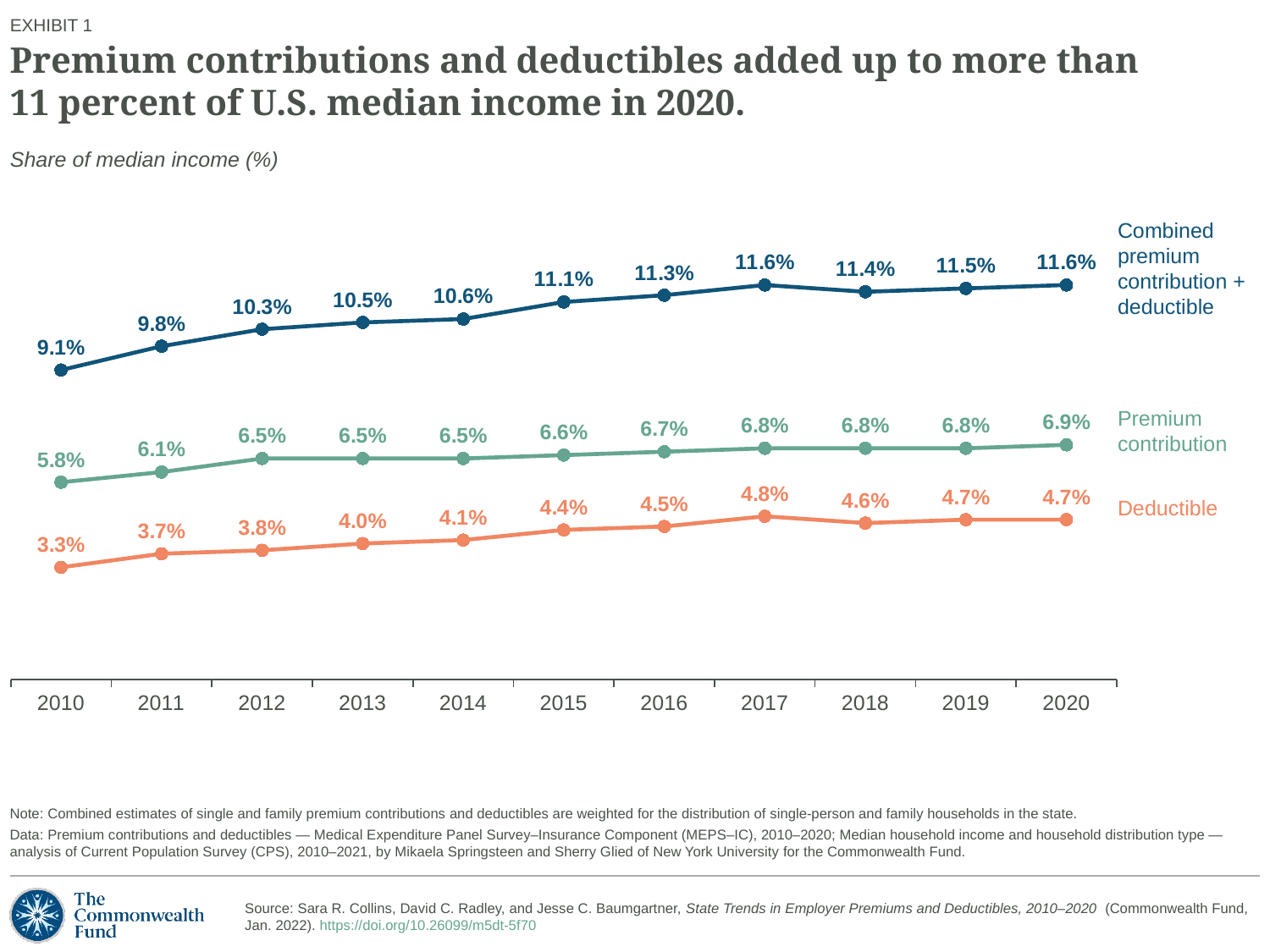
What was the premium contribution as a share of median income in 2015? 6.6% Which was larger in 2018: the premium contribution share or the deductible share? Premium contribution What was the deductible as a share of median income in 2010? 3.3% By how many percentage points did the combined premium contribution + deductible share rise from 2010 to 2020? 2.5 percentage points Does the deductible share of median income generally rise or fall from 2010 to 2020? Rise In which year was the premium contribution share of median income highest? 2020 What type of chart is shown on the slide? Line chart How many years are shown on the x axis? 11 What was the combined premium contribution + deductible as a share of median income in 2020? 11.6% What is the difference between the premium contribution and the deductible shares in 2017? 2.0 percentage points In which year was the deductible share of median income lowest? 2010 How many series are plotted on the chart? 3